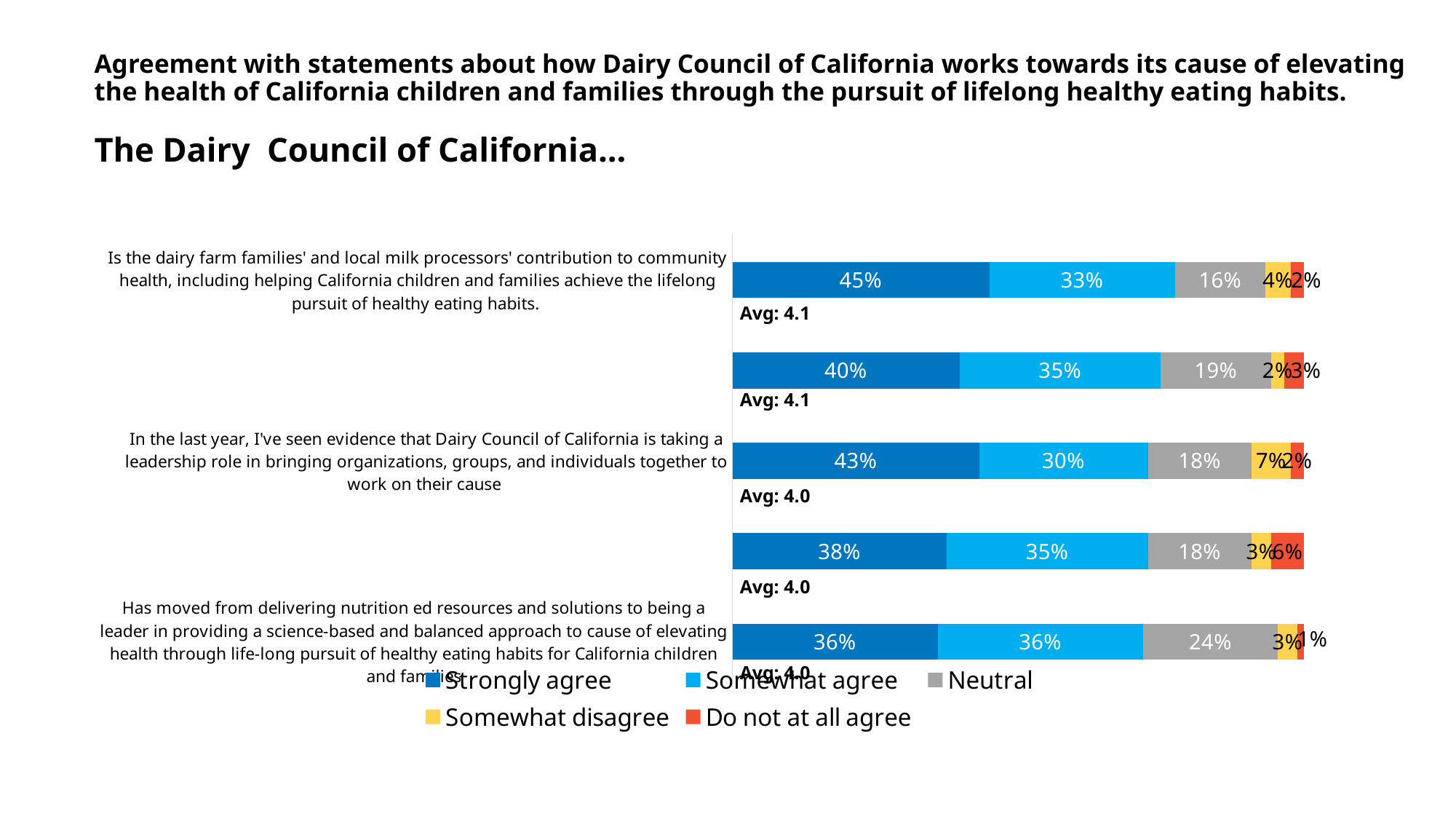
What is the Neutral percentage for the statement 'Has moved from delivering nutrition ed resources and solutions to being a leader...'? 24% What colour represents the 'Do not at all agree' series in the legend? Red How many bars are plotted in the chart? 5 What kind of chart is shown on the slide? Stacked bar chart Which statement has the highest Strongly agree percentage? Is the dairy farm families' and local milk processors' contribution to community health, including helping California children and families achieve the lifelong pursuit of healthy eating habits. Which is larger for the 'In the last year, I've seen evidence...' statement: the Strongly agree share or the Somewhat agree share? Strongly agree What is the difference between the Strongly agree percentages for the 'Is the dairy farm families'...' statement and the 'Has moved from delivering nutrition ed resources...' statement? 9% What is the Somewhat disagree percentage for the statement 'In the last year, I've seen evidence that Dairy Council of California is taking a leadership role...'? 7% How many series does the legend list? 5 What is the average score shown for the statement 'Is the dairy farm families' and local milk processors' contribution to community health...'? 4.1 What is the Strongly agree percentage for the statement 'Is the dairy farm families' and local milk processors' contribution to community health...'? 45%